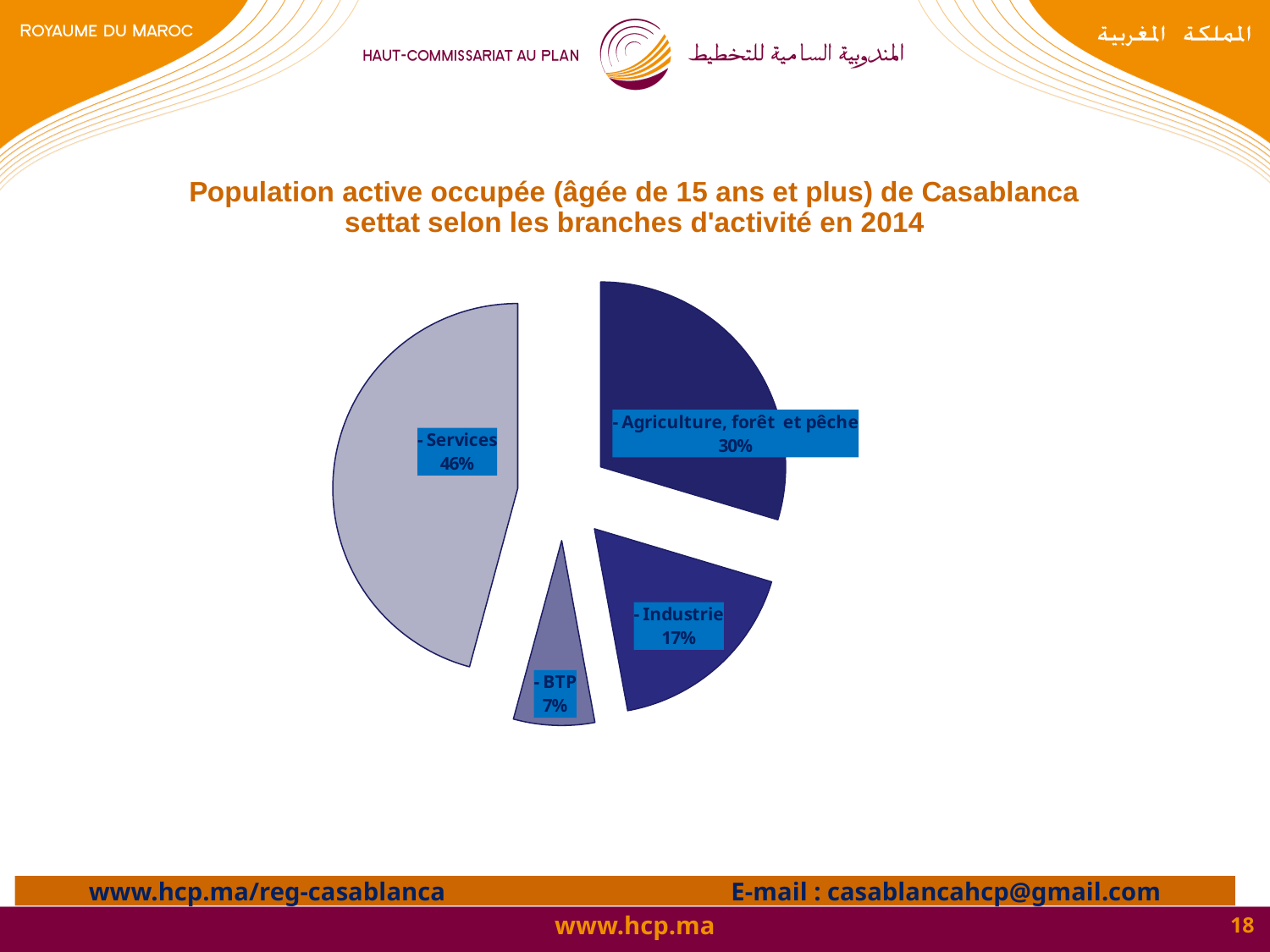
Which has a larger share, Industrie or BTP? Industrie What kind of chart is shown on the slide? Pie chart What share of the employed population works in Agriculture, forêt et pêche? 30% What is the difference in percentage points between the Services share and the Agriculture, forêt et pêche share? 16 Which branch of activity has the smallest share of the employed population? BTP What share of the employed population works in Services? 46% How many branches of activity are shown in the chart? 4 What share of the employed population works in BTP? 7% What is the difference in percentage points between the Industrie share and the BTP share? 10 What year does the chart title refer to? 2014 Which branch of activity has the largest share of the employed population? Services What share of the employed population works in Industrie? 17%